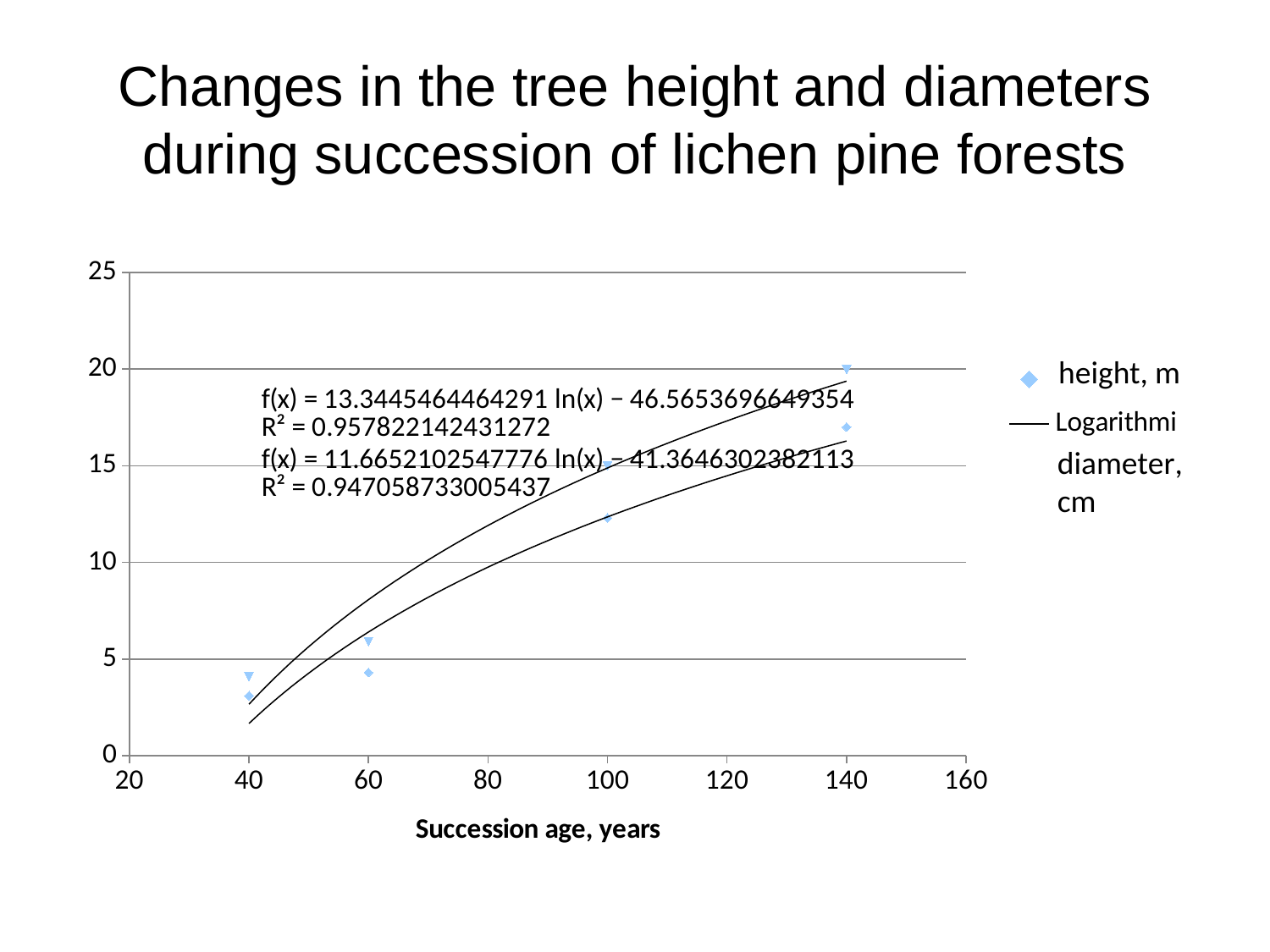
What kind of chart is shown on the slide? scatter chart Do the height and diameter values rise or fall as succession age increases? rise What R² value is printed for the first trendline equation (the one starting f(x) = 13.3445464464291 ln(x))? 0.957822142431272 Is the diameter value at succession age 60 greater or less than 5? greater How many succession ages have data points plotted on the chart? 4 Is the height value at succession age 40 greater or less than 5? less At succession age 140, which is larger: the diameter value or the height value? diameter At which succession age is the height value highest? 140 Is the height value at succession age 100 greater or less than 10? greater What is the title of the x axis? Succession age, years